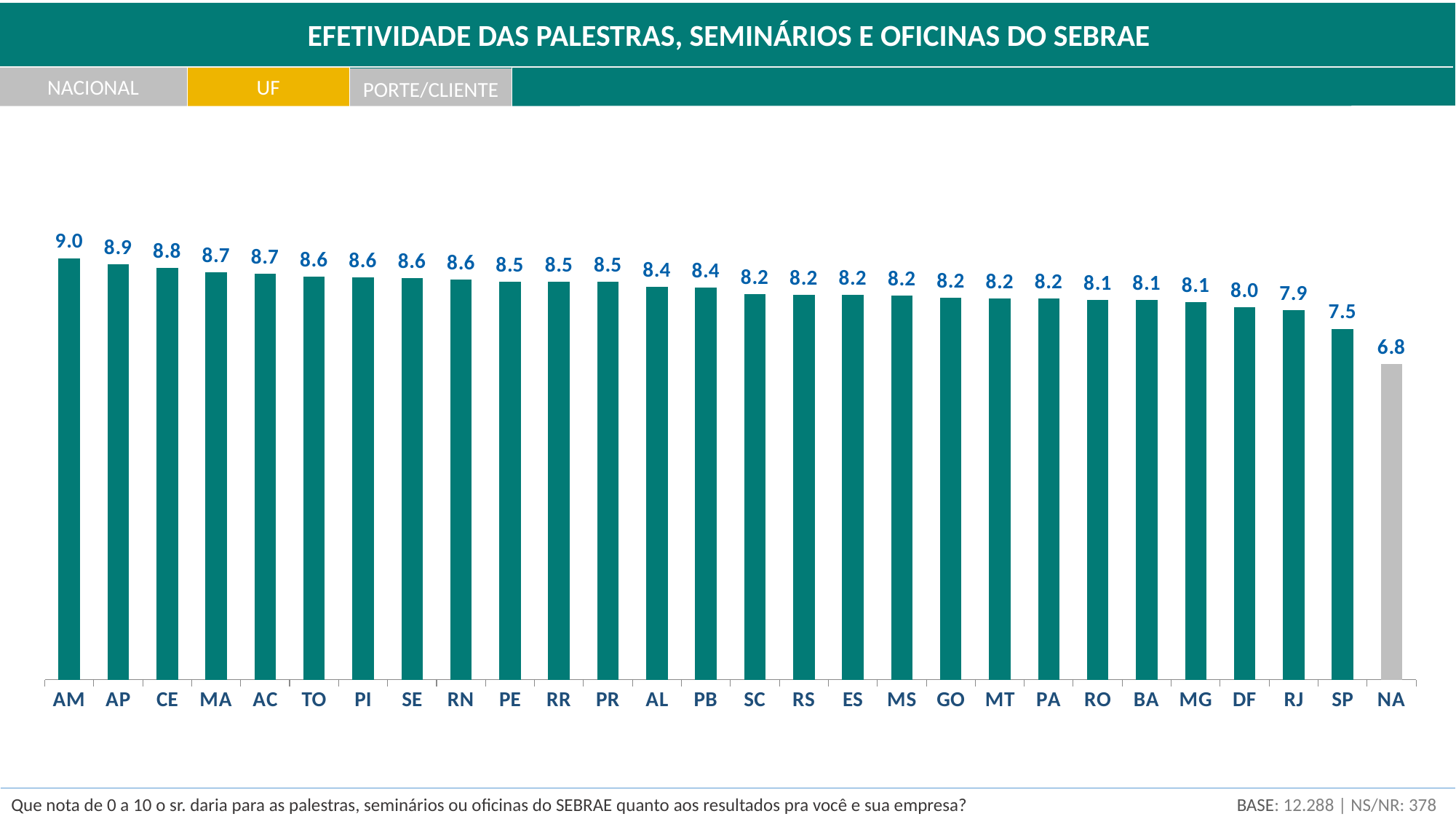
What is the difference between the values for AM and NA? 2.2 What is the difference between the values for CE and RJ? 0.9 What kind of chart is shown on the slide? bar chart Which category has the highest value? AM What is the value for DF? 8.0 What is the value for SP? 7.5 Which bar is shown in a different colour (grey) from the others? NA What is the value for NA? 6.8 Which category has the lowest value? NA How many categories are shown on the x axis? 28 What is the value for AM? 9.0 Which is larger, the value for AP or the value for SP? AP